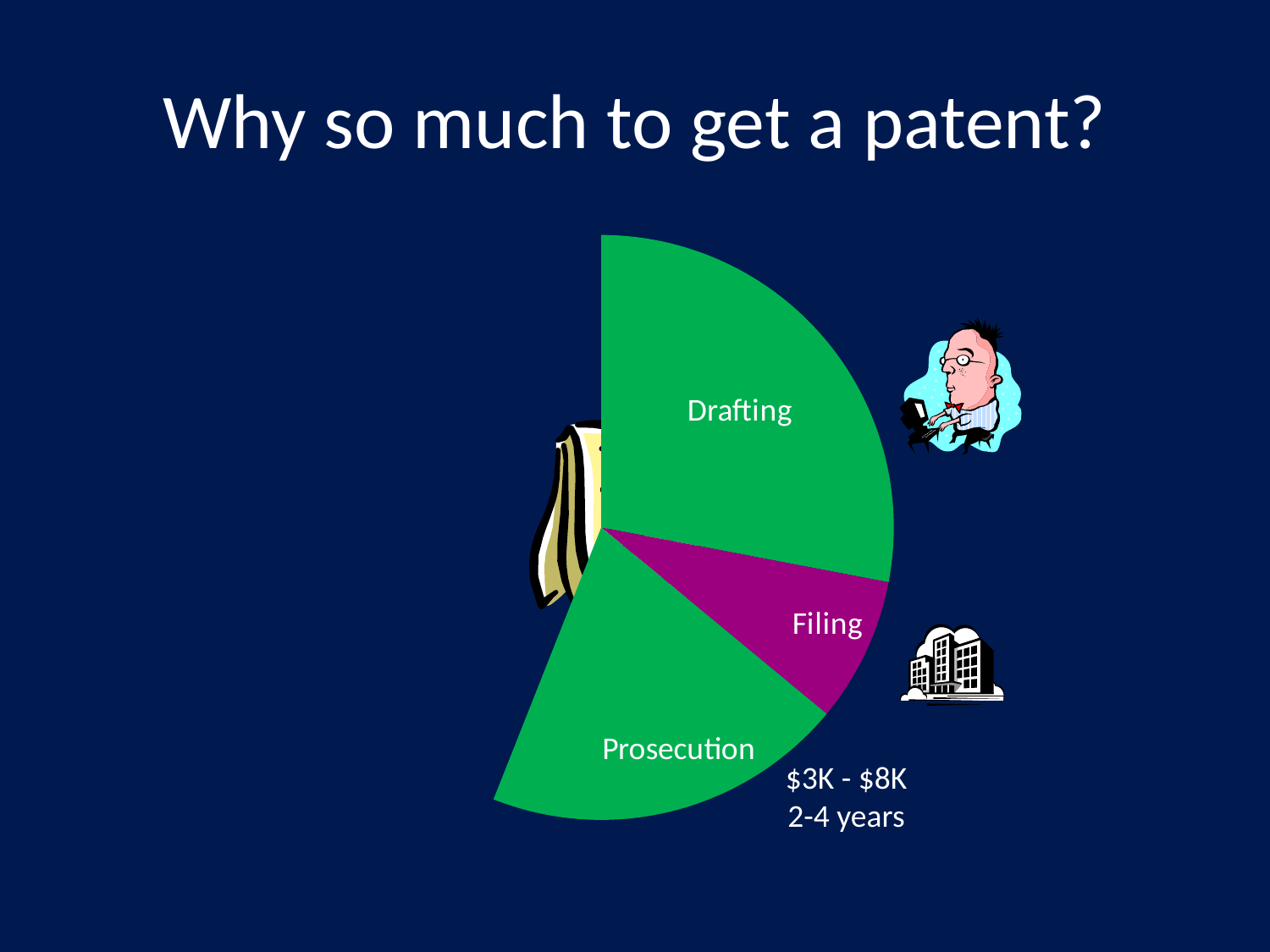
How many labeled slices does the pie chart have? 3 What is the title of the slide containing the pie chart? Why so much to get a patent? Which slice is larger, Drafting or Filing? Drafting Which slice of the pie chart is the smallest? Filing What colour is the Filing slice of the pie chart? Purple What kind of chart is shown on the slide? Pie chart Which slice is larger, Drafting or Prosecution? Drafting Which slice is larger, Filing or Prosecution? Prosecution Which slice of the pie chart is the largest? Drafting